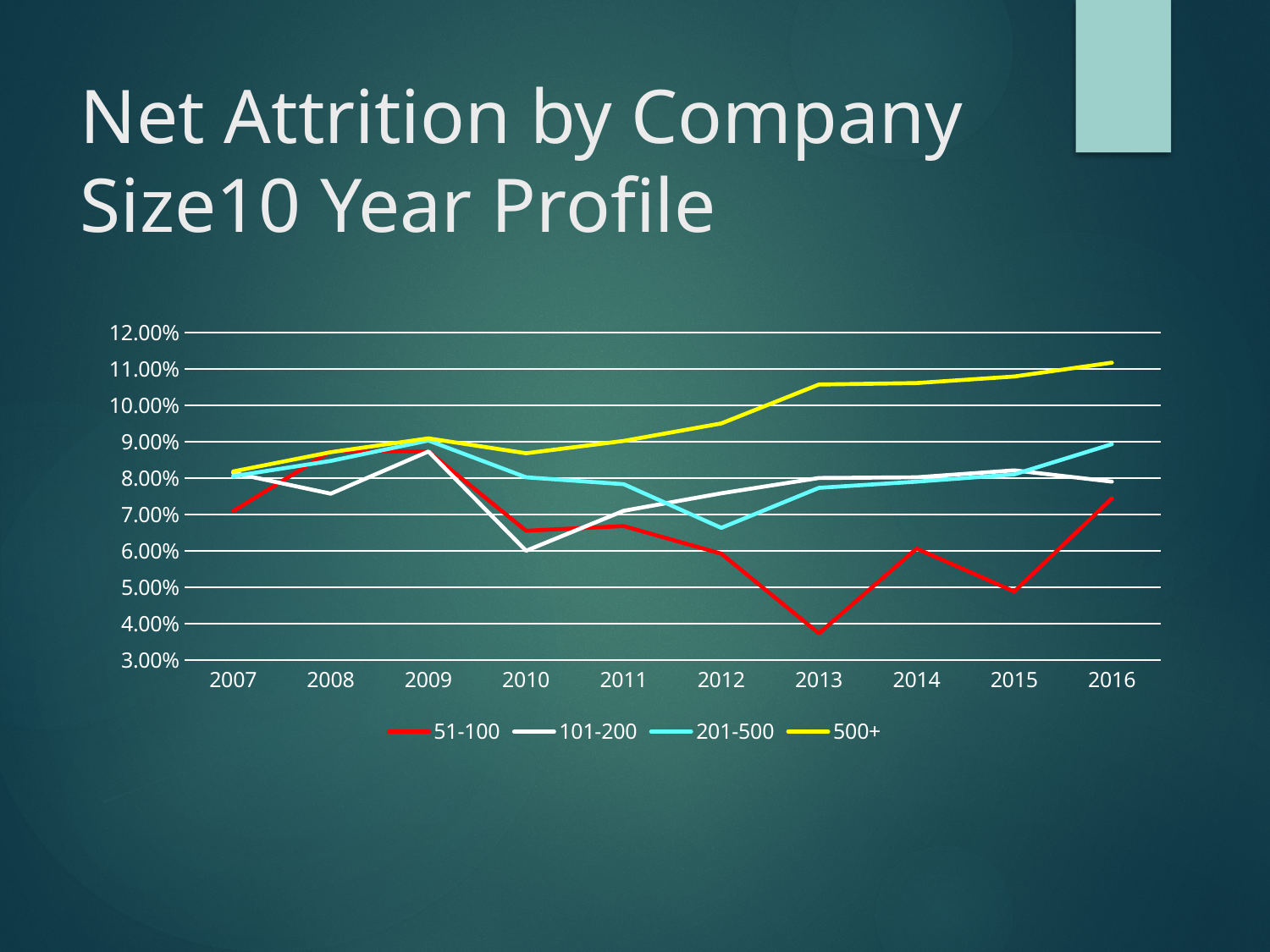
Is the value for 101-200 in 2010 greater or less than 7.00%? less Is the value for 500+ in 2016 greater or less than 11.00%? greater How many series does the legend list? 4 Does the 500+ series rise or fall from 2012 to 2016? rise Which series has the lowest value in 2013? 51-100 What kind of chart is shown on the slide? line chart In which year does the 51-100 series reach its lowest value? 2013 Is the value for 51-100 in 2013 greater or less than 5.00%? less Which series has the highest value in 2016? 500+ How many years are plotted along the x axis? 10 In 2010, which series has the larger value, 201-500 or 101-200? 201-500